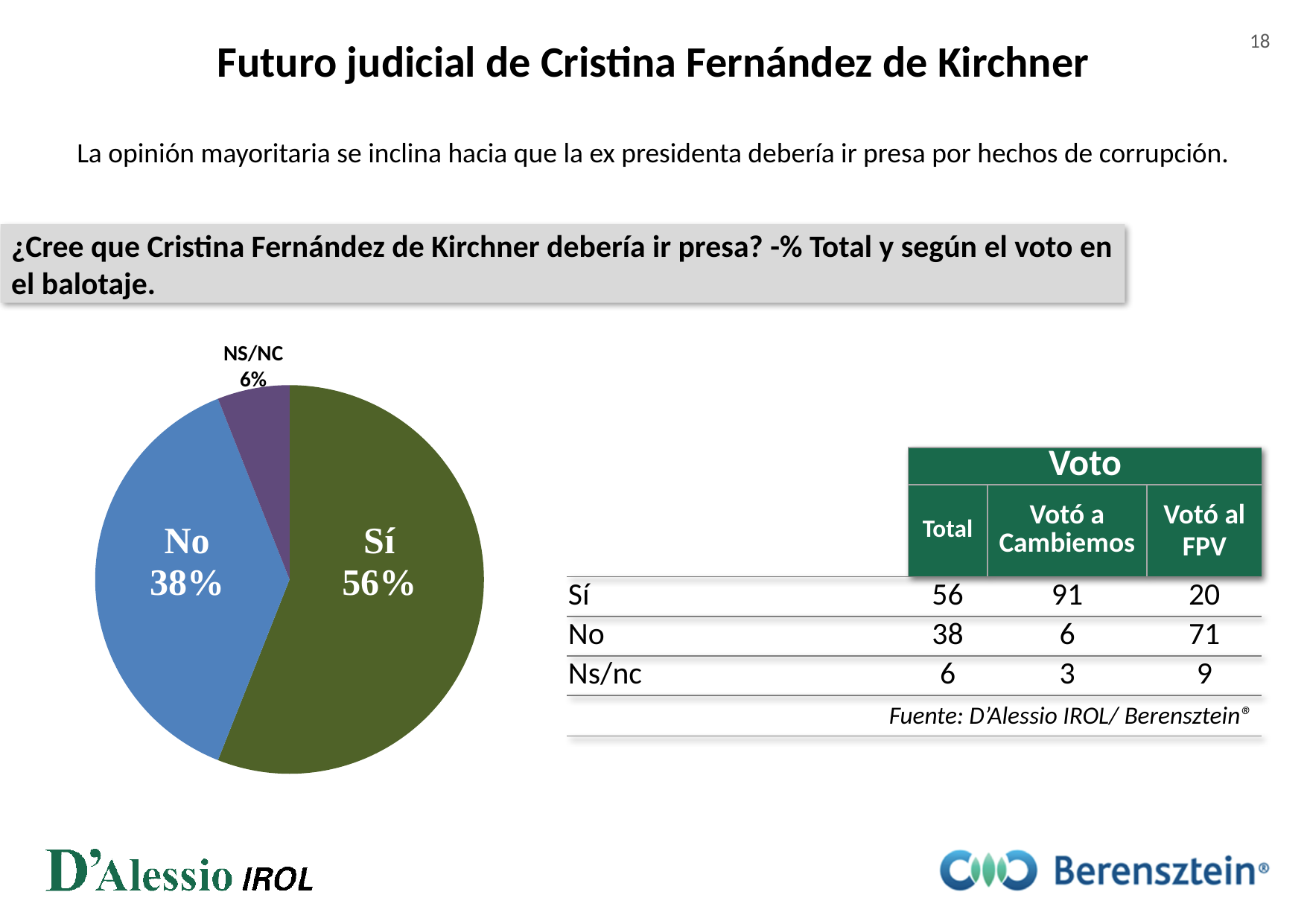
In the pie chart, what percentage of respondents answered Sí? 56% Which is larger in the pie chart, the No slice or the NS/NC slice? No How many slices does the pie chart have? 3 Which slice of the pie chart is the smallest? NS/NC Which slice of the pie chart is the largest? Sí What colour is the No slice of the pie chart? blue What colour is the Sí slice of the pie chart? green In the pie chart, what percentage is shown for NS/NC? 6% What kind of chart is shown on the slide? pie chart Is the Sí slice of the pie chart greater or less than half of the pie? greater In the pie chart, what percentage of respondents answered No? 38% What is the difference in percentage points between the Sí and No slices of the pie chart? 18